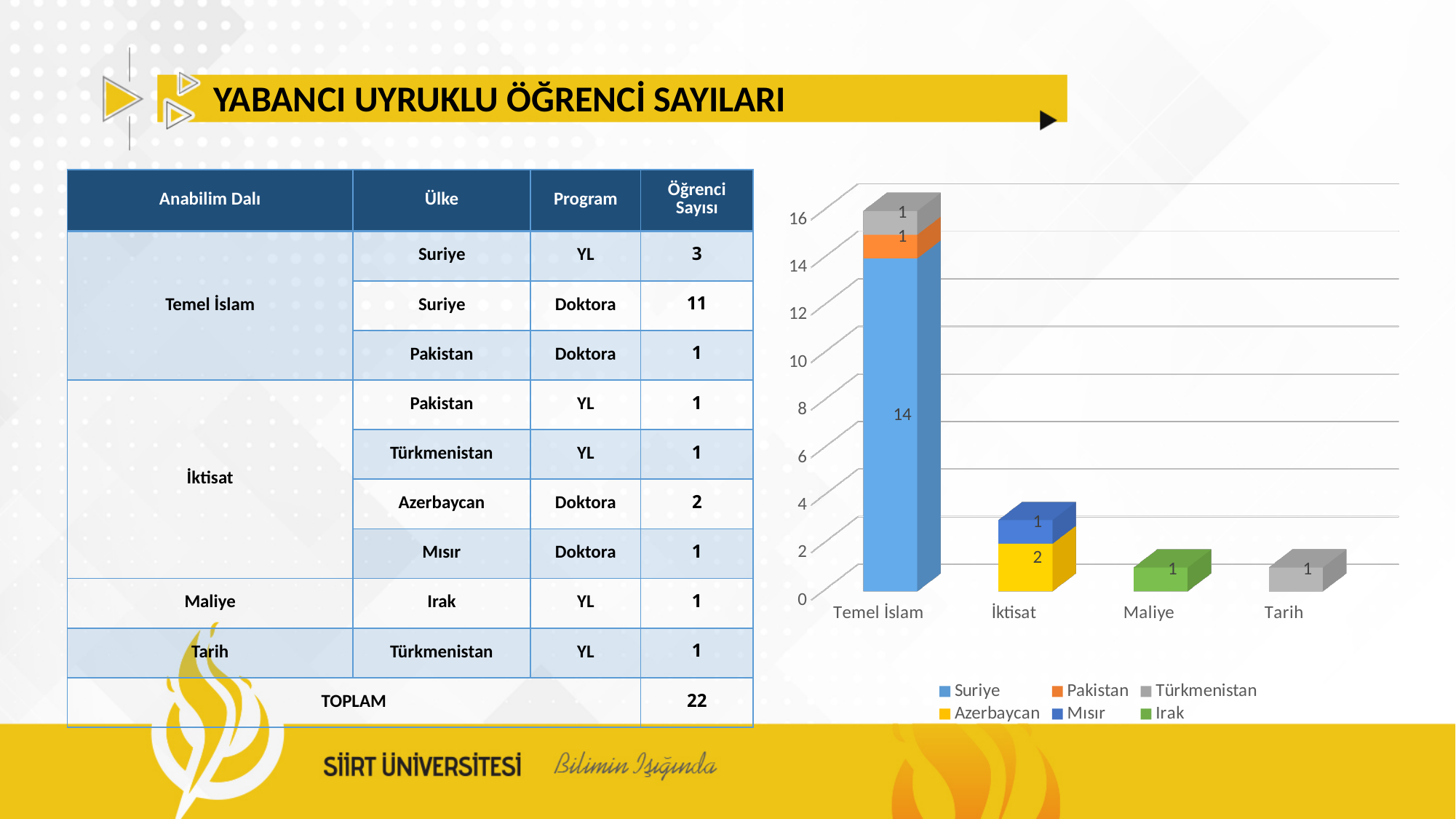
How many series does the chart legend list? 6 What is the difference between the Suriye value in Temel İslam and the Azerbaycan value in İktisat? 12 What is the total of the stacked bar for İktisat? 3 What is the value for Suriye in the Temel İslam bar? 14 Which legend entry is shown in yellow? Azerbaycan Which category has the tallest stacked bar? Temel İslam What is the value for Irak in the Maliye bar? 1 What is the total of the stacked bar for Temel İslam? 16 Which is larger: the Temel İslam bar total or the İktisat bar total? Temel İslam What is the value for Azerbaycan in the İktisat bar? 2 What kind of chart is shown on the slide? stacked bar chart How many categories are shown on the x axis of the chart? 4